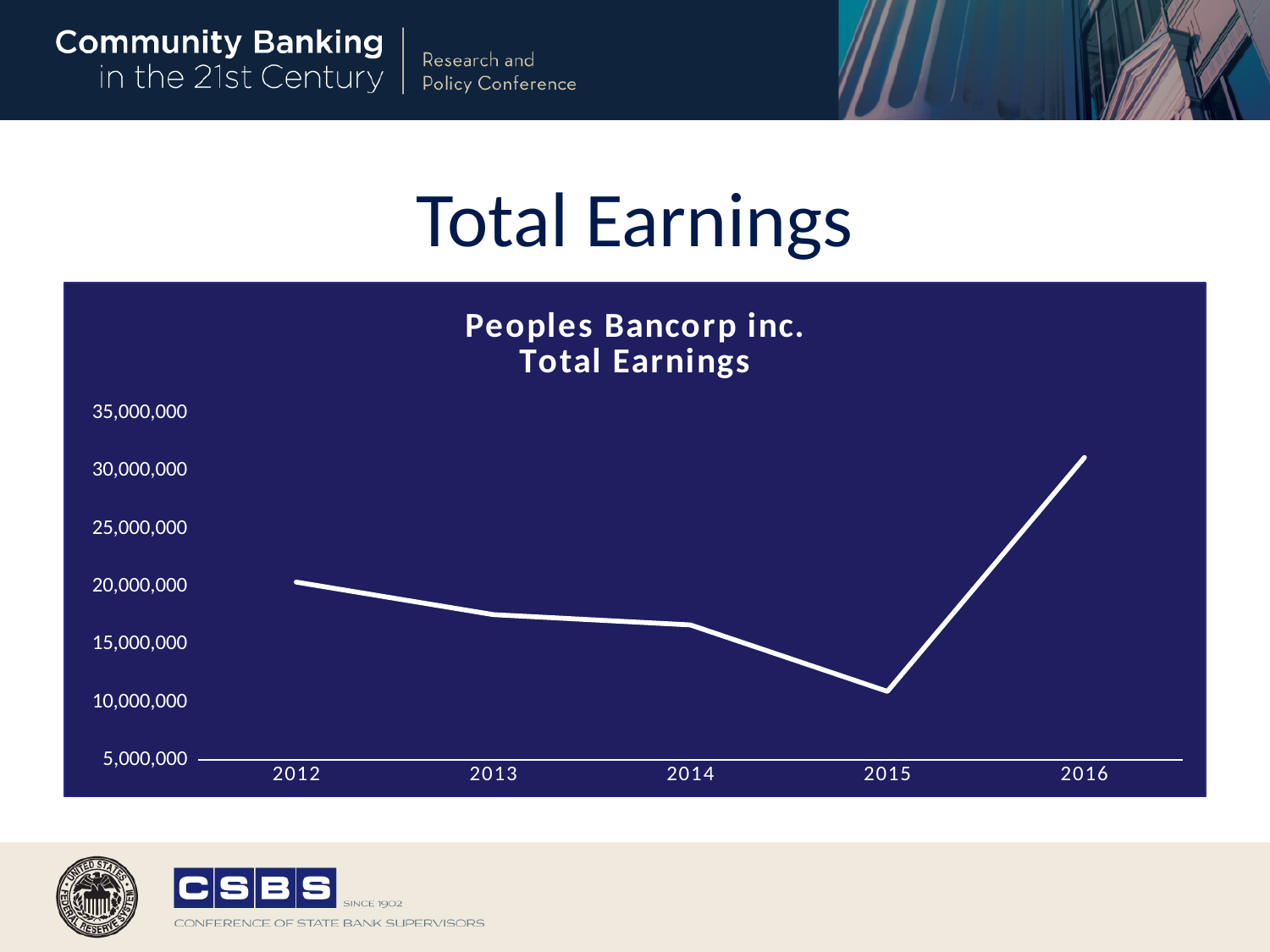
Which year has the highest total earnings? 2016 Is the value for 2013 greater or less than 20,000,000? less Is the value for 2015 greater or less than 15,000,000? less Which year has the lowest total earnings? 2015 What kind of chart is shown on the slide? line chart What colour is the line plotted on the chart? white Do total earnings rise or fall from 2012 to 2015? fall Which year has higher total earnings, 2012 or 2015? 2012 What is the title of the chart? Peoples Bancorp inc. Total Earnings Is the value for 2016 greater or less than 25,000,000? greater How many years are plotted on the x axis of the chart? 5